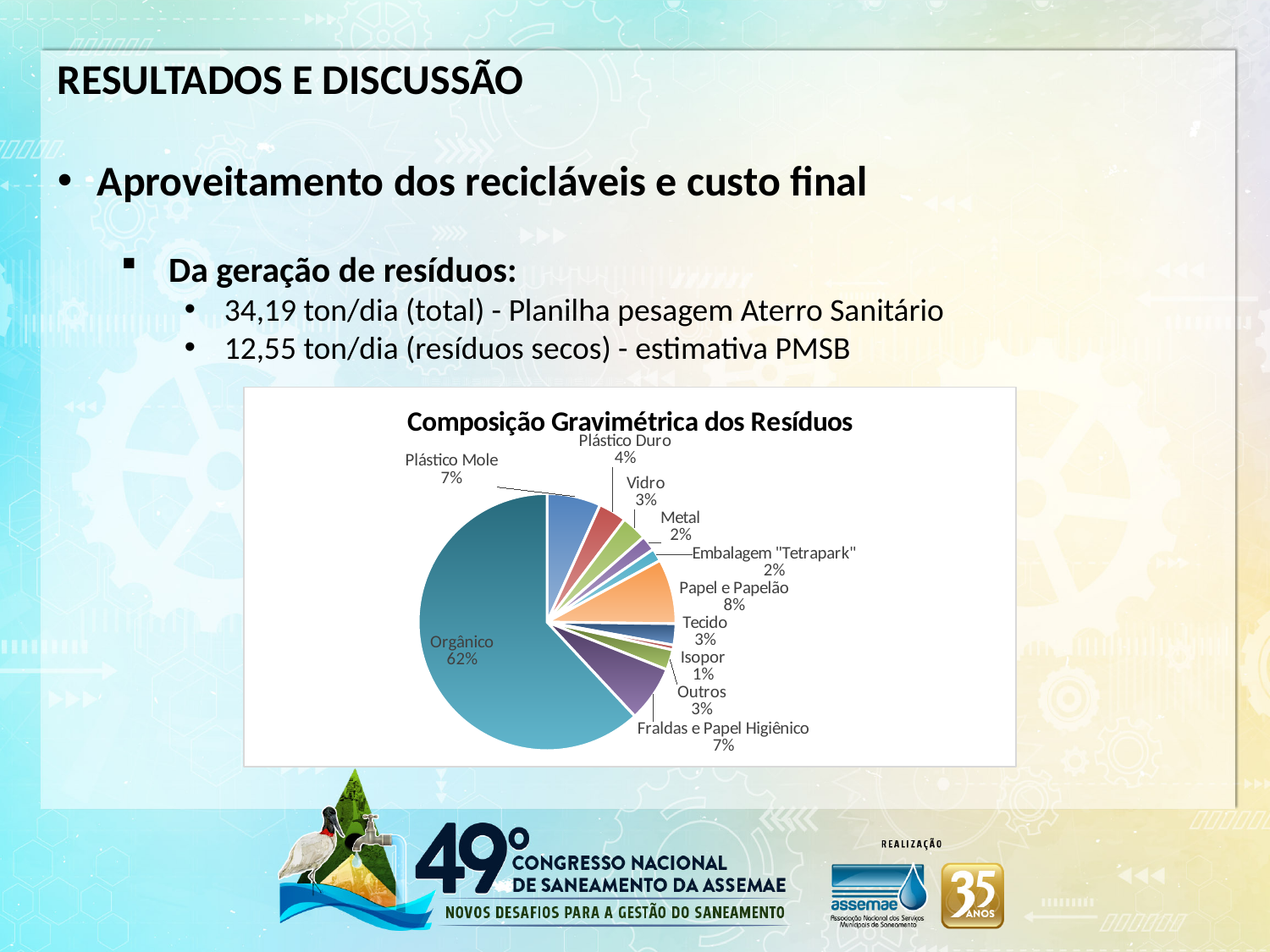
What is the title of the chart? Composição Gravimétrica dos Resíduos What is the value shown for Embalagem "Tetrapark"? 2% What is the value shown for Fraldas e Papel Higiênico? 7% What is the value shown for Plástico Duro? 4% What share of the pie does Orgânico represent? 62% What is the value shown for Papel e Papelão? 8% What kind of chart is shown on the slide? pie chart How many categories are shown in the pie chart? 11 Which category has the smallest slice of the pie? Isopor What is the difference between the shares of Papel e Papelão and Vidro? 5% Which is larger, the share of Plástico Mole or the share of Plástico Duro? Plástico Mole Which category has the largest slice of the pie? Orgânico